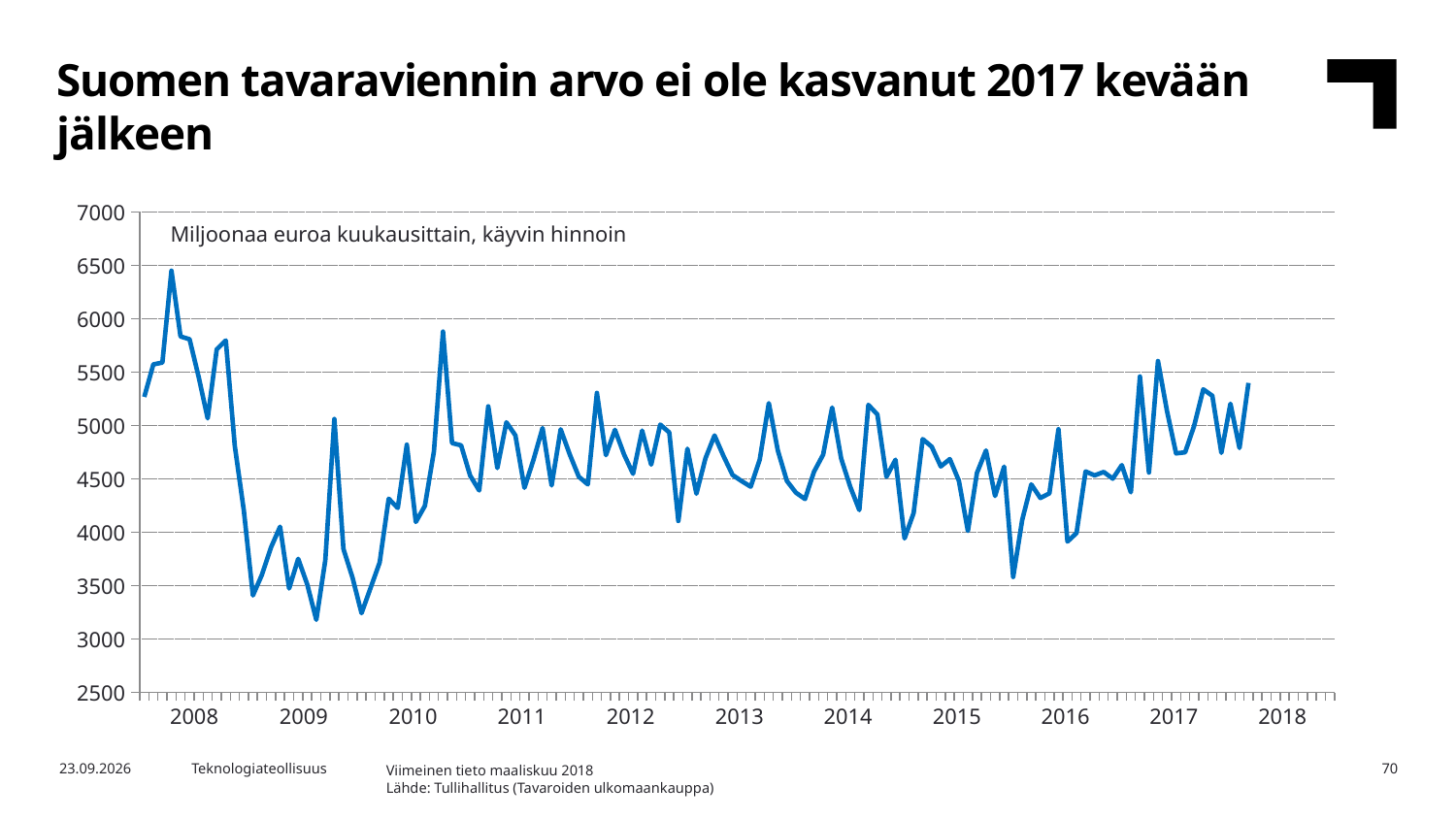
How many lines (data series) are plotted in the chart? 1 Is the highest value in 2008 greater or less than 6000? greater Which is higher: the peak value in 2008 or the peak value in 2017? 2008 Does the line rise or fall over the course of 2008? fall In which year does the line reach its highest value? 2008 Is the lowest value in 2009 greater or less than 3500? less What is the title of the slide? Suomen tavaraviennin arvo ei ole kasvanut 2017 kevään jälkeen What unit does the text inside the chart say the values are in? Miljoonaa euroa kuukausittain, käyvin hinnoin What kind of chart is shown on the slide? line chart Is the highest value in 2017 greater or less than 5000? greater In which year does the line reach its lowest value? 2009